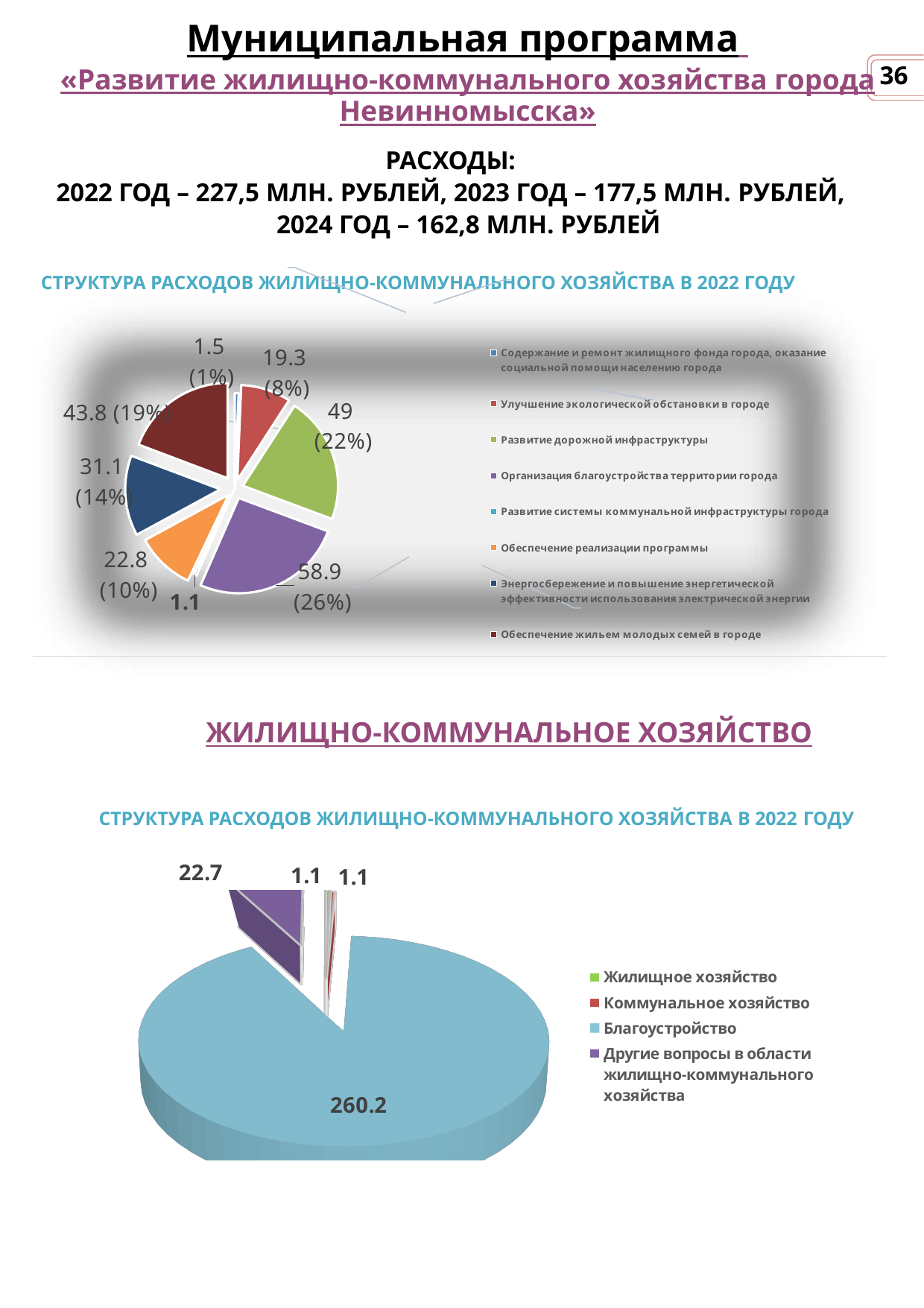
What kind of chart is the bottom chart on the slide? pie chart In the top pie chart, what is the value for Обеспечение жильем молодых семей в городе? 43.8 What kind of chart is the top chart on the slide? pie chart In the top pie chart, what is the value for Организация благоустройства территории города? 58.9 In the top pie chart, what share of the pie does Развитие дорожной инфраструктуры take? 22% In the bottom pie chart, which is larger: Другие вопросы в области жилищно-коммунального хозяйства or Жилищное хозяйство? Другие вопросы в области жилищно-коммунального хозяйства In the top pie chart, which category has the largest value? Организация благоустройства территории города In the bottom pie chart, which category has the largest value? Благоустройство In the top pie chart, what is the difference between the values for Обеспечение жильем молодых семей в городе and Энергосбережение и повышение энергетической эффективности использования электрической энергии? 12.7 In the bottom pie chart, what is the value for Благоустройство? 260.2 In the top pie chart, how many categories does the legend list? 8 In the bottom pie chart, how many categories does the legend list? 4